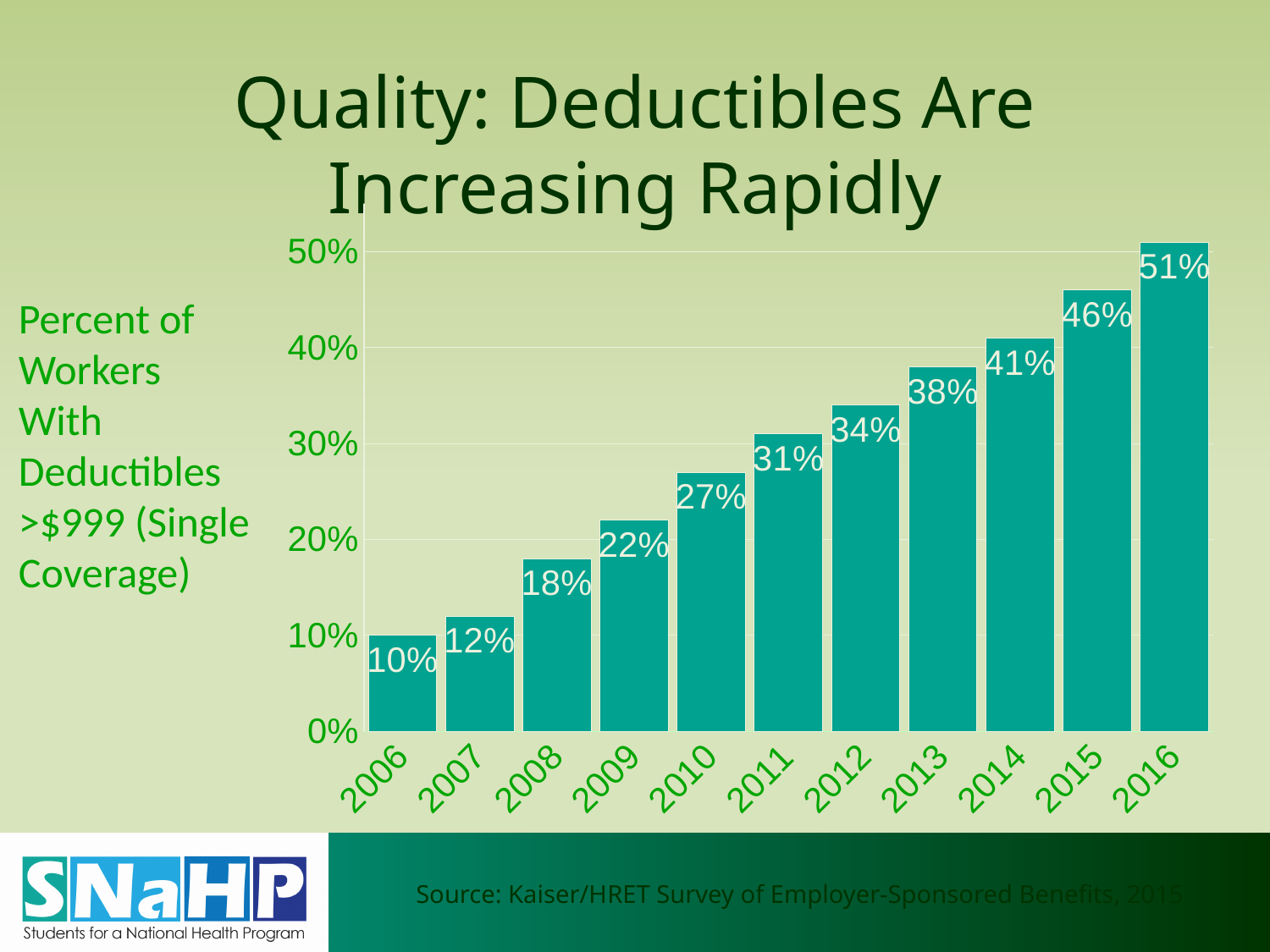
What kind of chart is shown on the slide? bar chart Which year has the highest value? 2016 Do the values rise or fall from 2006 to 2016? rise Which is larger, the value for 2009 or the value for 2011? 2011 Is the value for 2015 greater or less than 40%? greater What is the value for 2014? 41% What is the value for 2006? 10% Which year has the lowest value? 2006 What is the difference between the values for 2013 and 2012? 4% What is the difference between the values for 2016 and 2006? 41% How many years are shown on the x axis? 11 What is the value for 2010? 27%